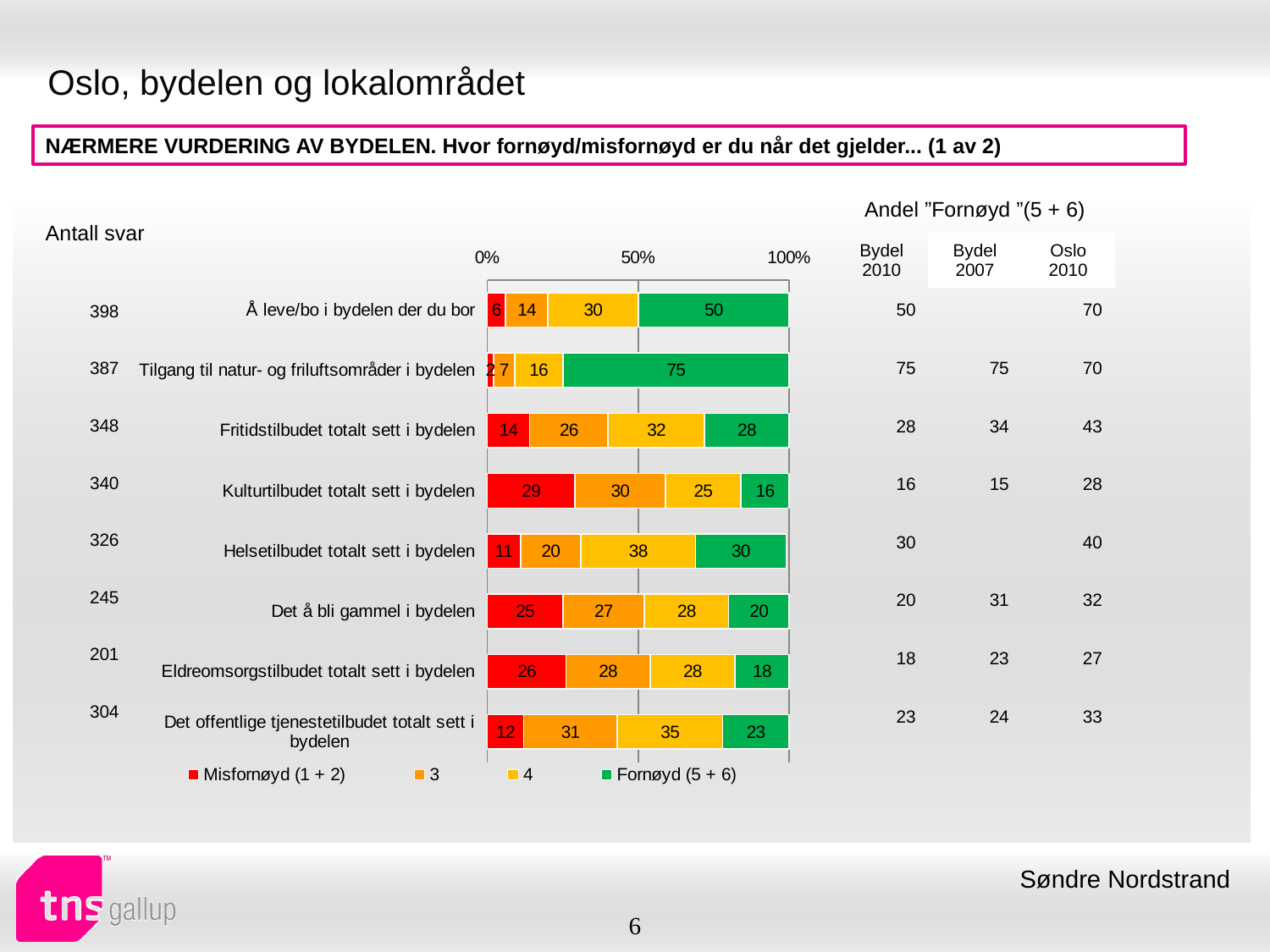
What is the Misfornøyd (1 + 2) value for "Kulturtilbudet totalt sett i bydelen"? 29 How many categories are plotted in the chart? 8 Which colour represents the Fornøyd (5 + 6) series in the chart? Green Which category has the lowest Fornøyd (5 + 6) value? Kulturtilbudet totalt sett i bydelen How many series does the chart legend list? 4 What is the total of the stacked bar for "Eldreomsorgstilbudet totalt sett i bydelen"? 100 Which category has the highest Fornøyd (5 + 6) value? Tilgang til natur- og friluftsområder i bydelen What is the difference between the Fornøyd (5 + 6) values for "Å leve/bo i bydelen der du bor" and "Fritidstilbudet totalt sett i bydelen"? 22 What is the Fornøyd (5 + 6) value for "Tilgang til natur- og friluftsområder i bydelen"? 75 What is the value of series "4" for "Helsetilbudet totalt sett i bydelen"? 38 What kind of chart is shown on the slide? Stacked bar chart Which has a larger Misfornøyd (1 + 2) value: "Det å bli gammel i bydelen" or "Det offentlige tjenestetilbudet totalt sett i bydelen"? Det å bli gammel i bydelen